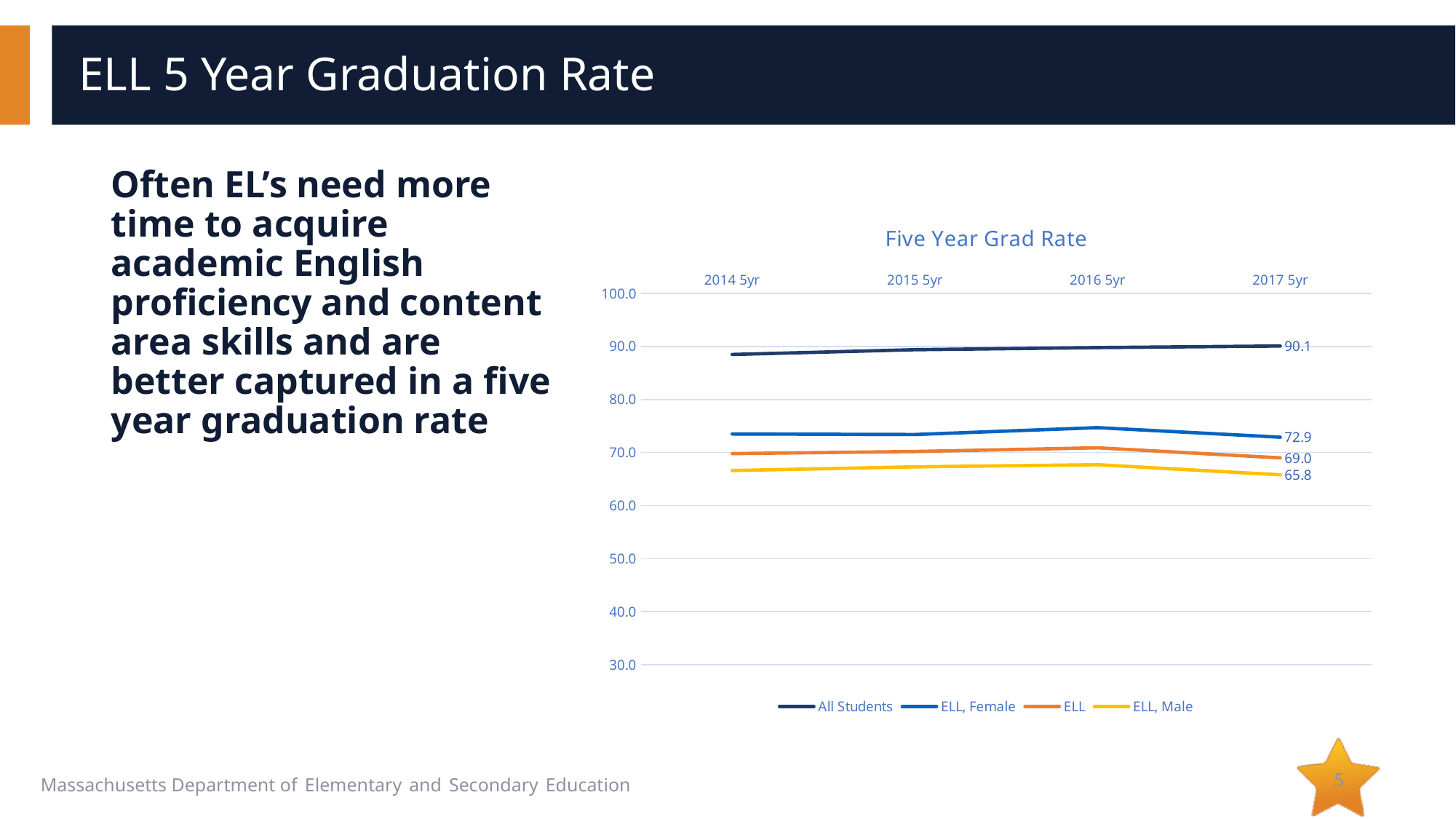
What is the value for All Students in 2017 5yr? 90.1 Which series has the lowest value in 2017 5yr? ELL, Male Which series has the highest value in 2017 5yr? All Students What is the difference between the All Students and ELL values in 2017 5yr? 21.1 What kind of chart is shown on the slide? Line chart What is the title of the chart? Five Year Grad Rate How many series does the legend list? 4 What is the value for ELL, Female in 2017 5yr? 72.9 Which is larger in 2017 5yr, ELL, Female or ELL, Male? ELL, Female What is the value for ELL, Male in 2017 5yr? 65.8 What is the value for ELL in 2017 5yr? 69.0 Is the value for All Students in 2014 5yr greater or less than 80.0? greater